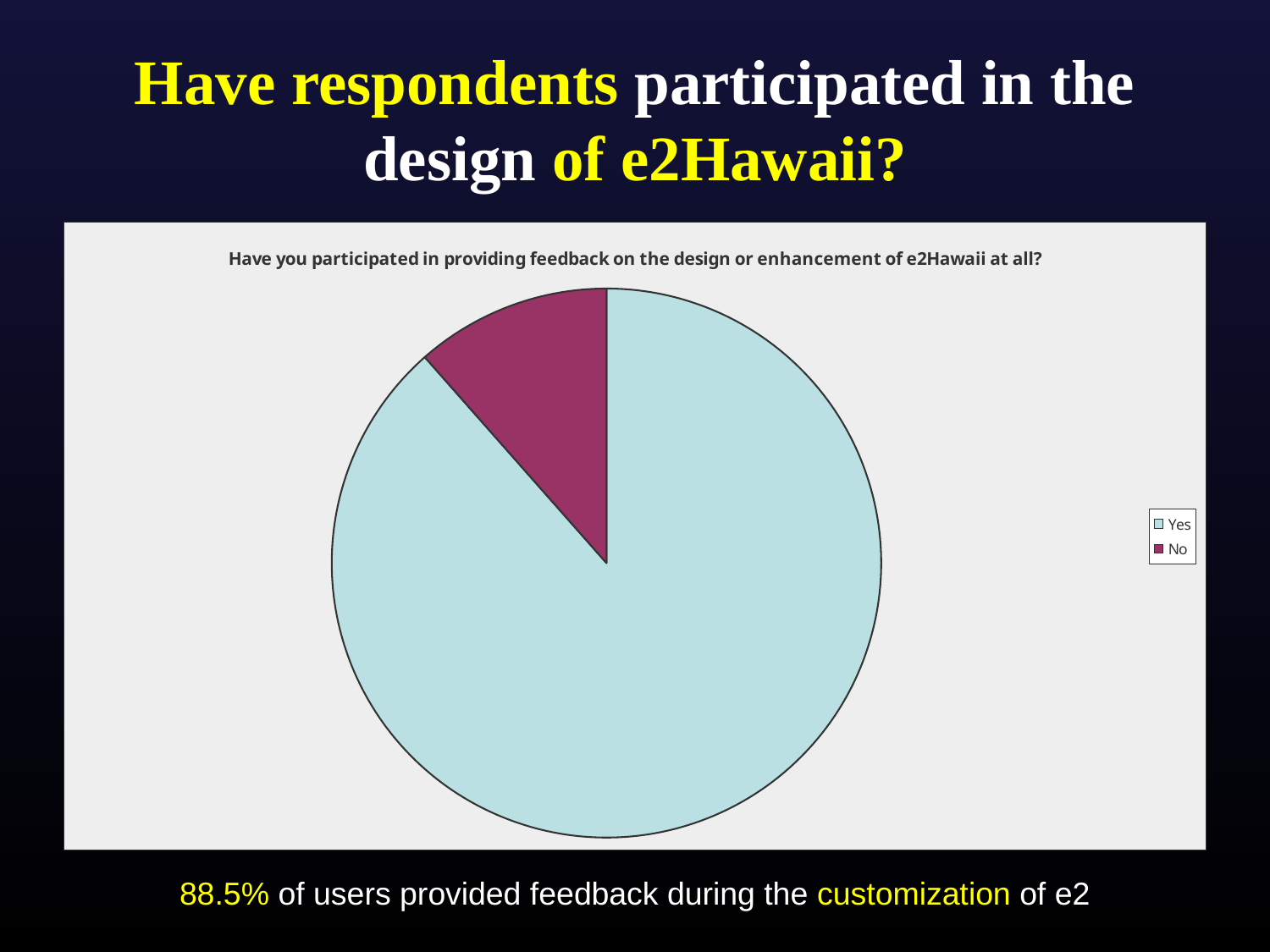
Which colour represents the No slice in the pie chart? dark magenta According to the slide, what share of users provided feedback during the customization of e2? 88.5% Which response has the smallest slice in the pie chart? No What kind of chart is shown on the slide? pie chart Which slice is larger in the pie chart, Yes or No? Yes How many slices does the pie chart have? 2 Which response has the largest slice in the pie chart? Yes How many entries does the legend of the pie chart list? 2 What is the title of the pie chart? Have you participated in providing feedback on the design or enhancement of e2Hawaii at all?